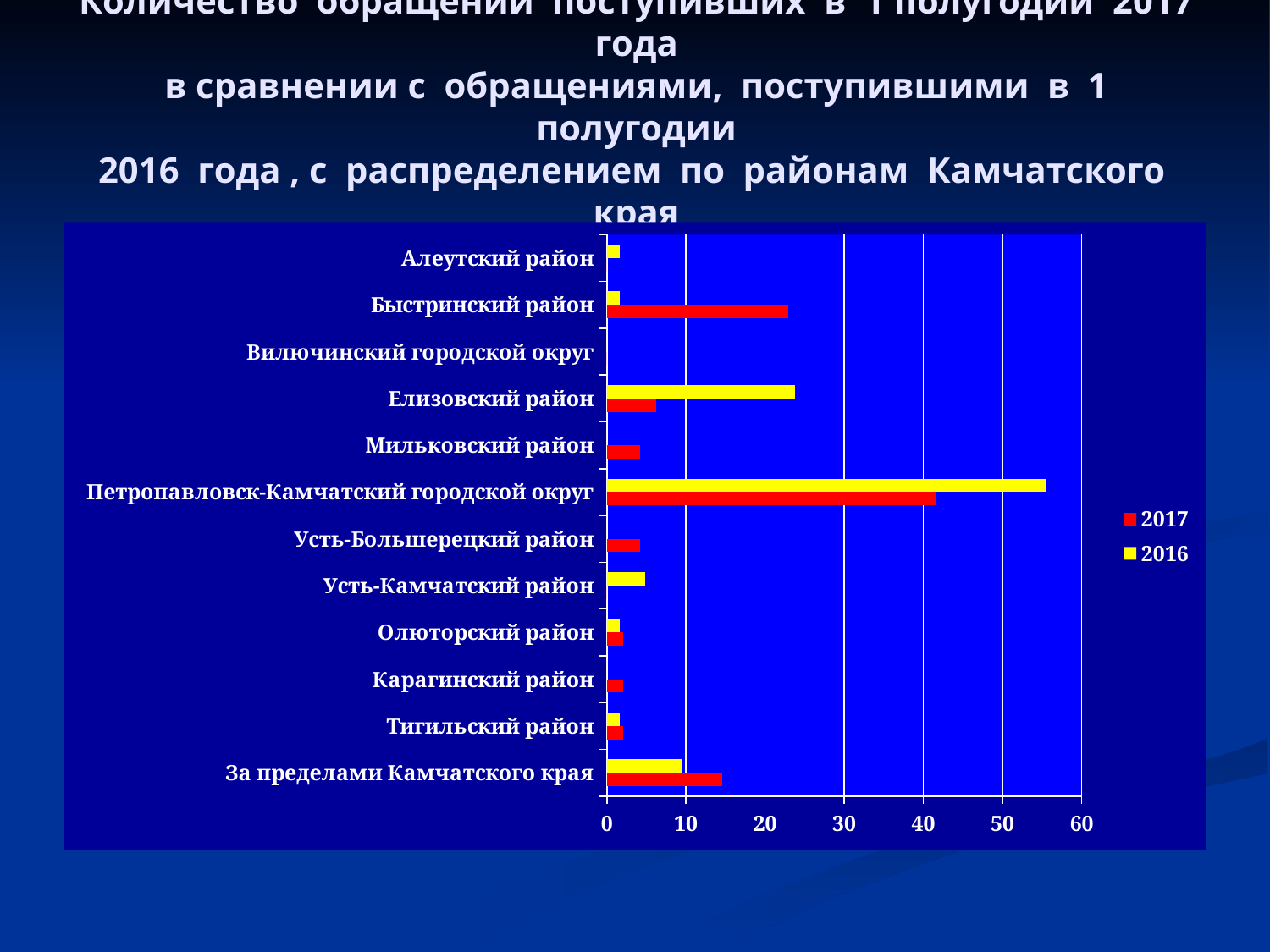
How many categories (districts) are shown on the vertical axis? 12 Is the 2017 value for Петропавловск-Камчатский городской округ greater or less than 50? less Is the 2017 value for Быстринский район greater or less than 20? greater Which category has the highest value for 2016? Петропавловск-Камчатский городской округ Is the 2016 value for Елизовский район greater or less than 20? greater Which colour represents the 2017 series in the legend? red Which category has the highest value for 2017? Петропавловск-Камчатский городской округ For За пределами Камчатского края, which year has the larger value, 2016 or 2017? 2017 For Елизовский район, which year has the larger value, 2016 or 2017? 2016 What kind of chart is shown on the slide? bar chart How many series does the legend list? 2